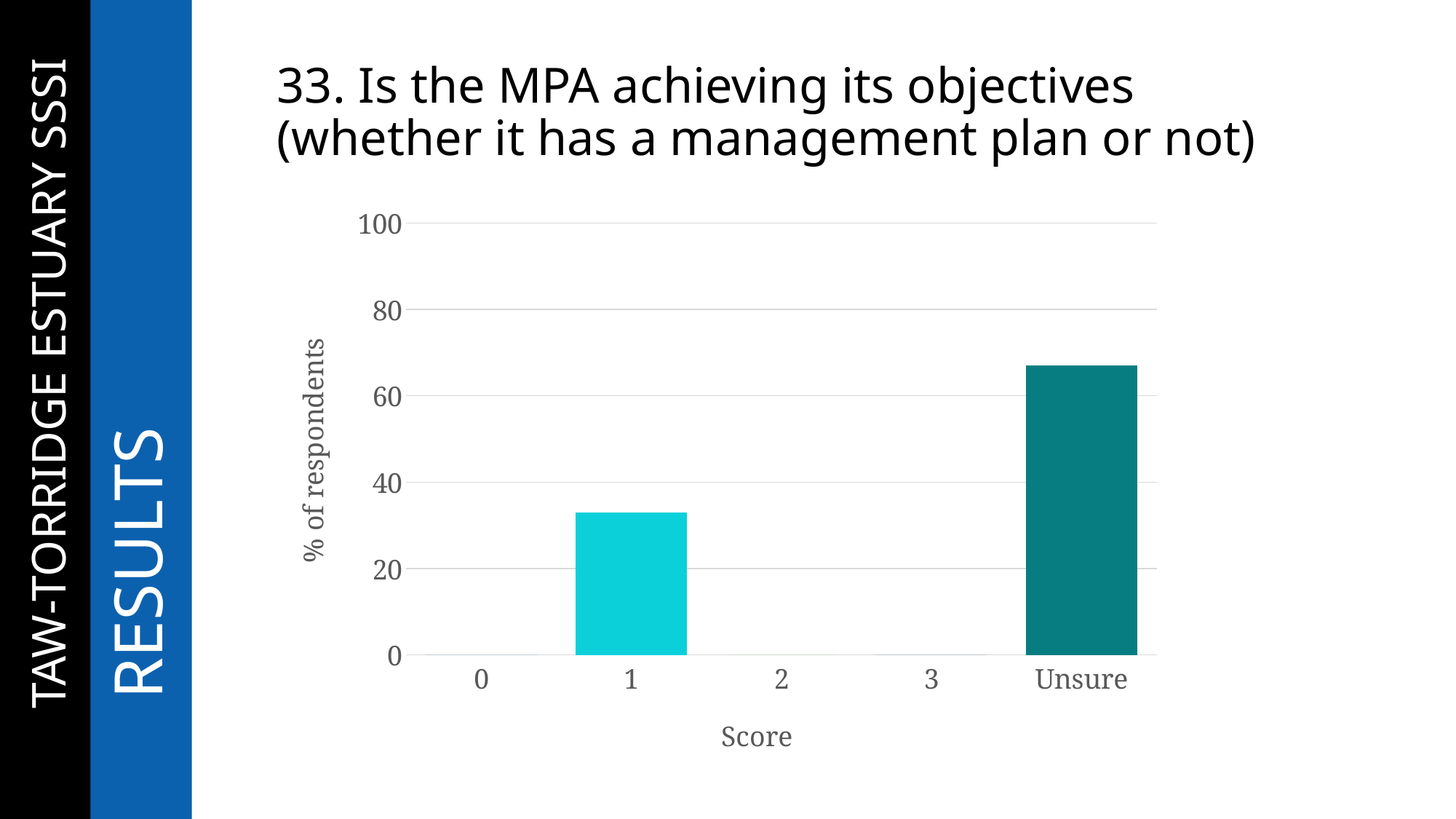
Which is larger, the value for score 1 or the value for Unsure? Unsure Is the value for Unsure greater or less than 60? greater Is the value for Unsure greater or less than 80? less Is the value for score 1 greater or less than 20? greater What is the label of the x axis? Score Which score category has the highest percentage of respondents? Unsure What is the highest value shown on the y axis? 100 Which score categories have no visible bar in the chart? 0, 2 and 3 What kind of chart is shown on the slide? bar chart What is the label of the y axis? % of respondents How many categories are shown on the x axis of the chart? 5